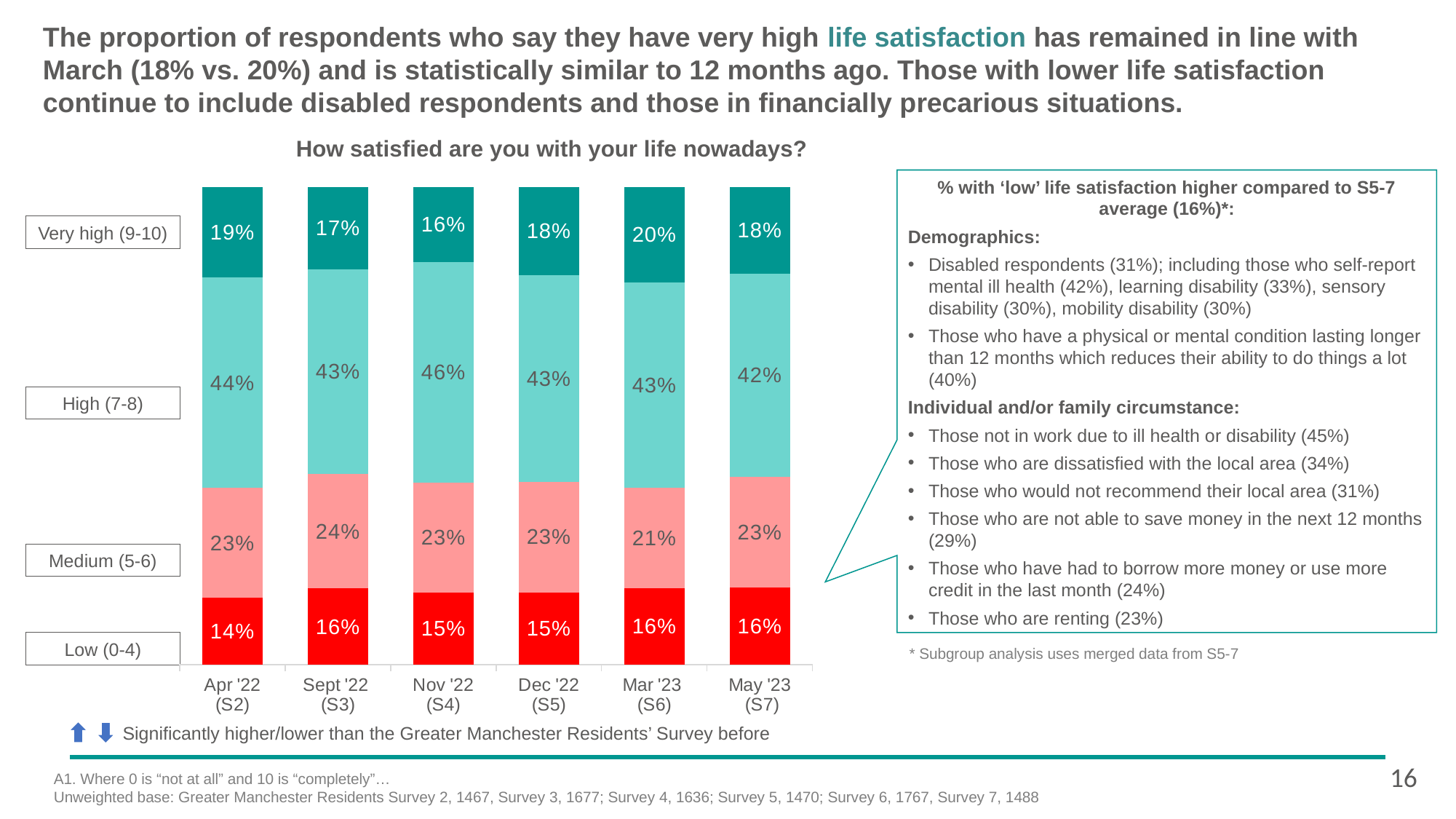
What percentage of respondents reported low (0-4) life satisfaction in Apr '22 (S2)? 14% In which survey wave was the proportion with very high (9-10) life satisfaction the highest? Mar '23 (S6) How many life satisfaction categories are stacked in each bar? 4 What percentage of respondents reported very high (9-10) life satisfaction in Mar '23 (S6)? 20% How many survey waves are shown on the x axis of the chart? 6 Does the very high (9-10) share rise or fall from Apr '22 (S2) to Nov '22 (S4)? Fall What is the title of the chart? How satisfied are you with your life nowadays? In which survey wave was the proportion with low (0-4) life satisfaction the lowest? Apr '22 (S2) What percentage of respondents reported high (7-8) life satisfaction in Nov '22 (S4)? 46% By how many percentage points did the very high (9-10) share change between Mar '23 (S6) and May '23 (S7)? 2 percentage points Which wave had a larger share of high (7-8) life satisfaction, Apr '22 (S2) or Sept '22 (S3)? Apr '22 (S2) What type of chart is used to show life satisfaction by survey wave? Stacked bar chart